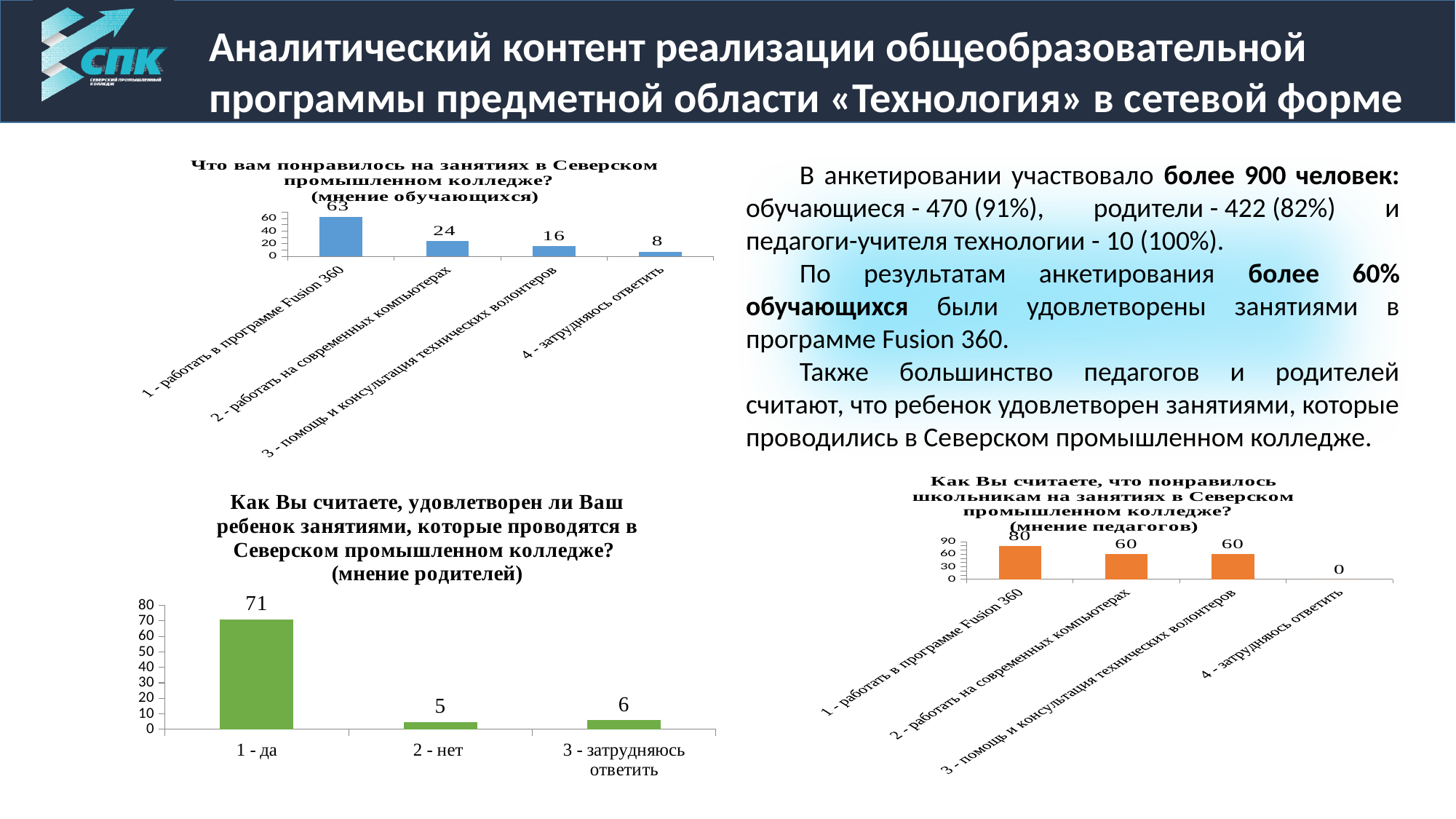
In the top-left chart (мнение обучающихся), what is the difference between the values for '2 - работать на современных компьютерах' and '3 - помощь и консультация технических волонтеров'? 8 What colour are the bars in the bottom-right chart (мнение педагогов)? Orange In the top-left chart (мнение обучающихся), which category has the lowest value? 4 - затрудняюсь ответить In the top-left chart (мнение обучающихся), what is the value for '1 - работать в программе Fusion 360'? 63 How many categories are shown in the top-left chart (мнение обучающихся)? 4 In the bottom-left chart (мнение родителей), which is larger: '2 - нет' or '3 - затрудняюсь ответить'? 3 - затрудняюсь ответить In the bottom-left chart (мнение родителей), what is the difference between the values for '1 - да' and '2 - нет'? 66 What type of chart is the bottom-left chart (мнение родителей)? Bar chart In the bottom-left chart (мнение родителей), what is the value for '1 - да'? 71 In the bottom-right chart (мнение педагогов), what is the value for '4 - затрудняюсь ответить'? 0 In the bottom-right chart (мнение педагогов), which category has the highest value? 1 - работать в программе Fusion 360 In the bottom-right chart (мнение педагогов), what is the value for '1 - работать в программе Fusion 360'? 80